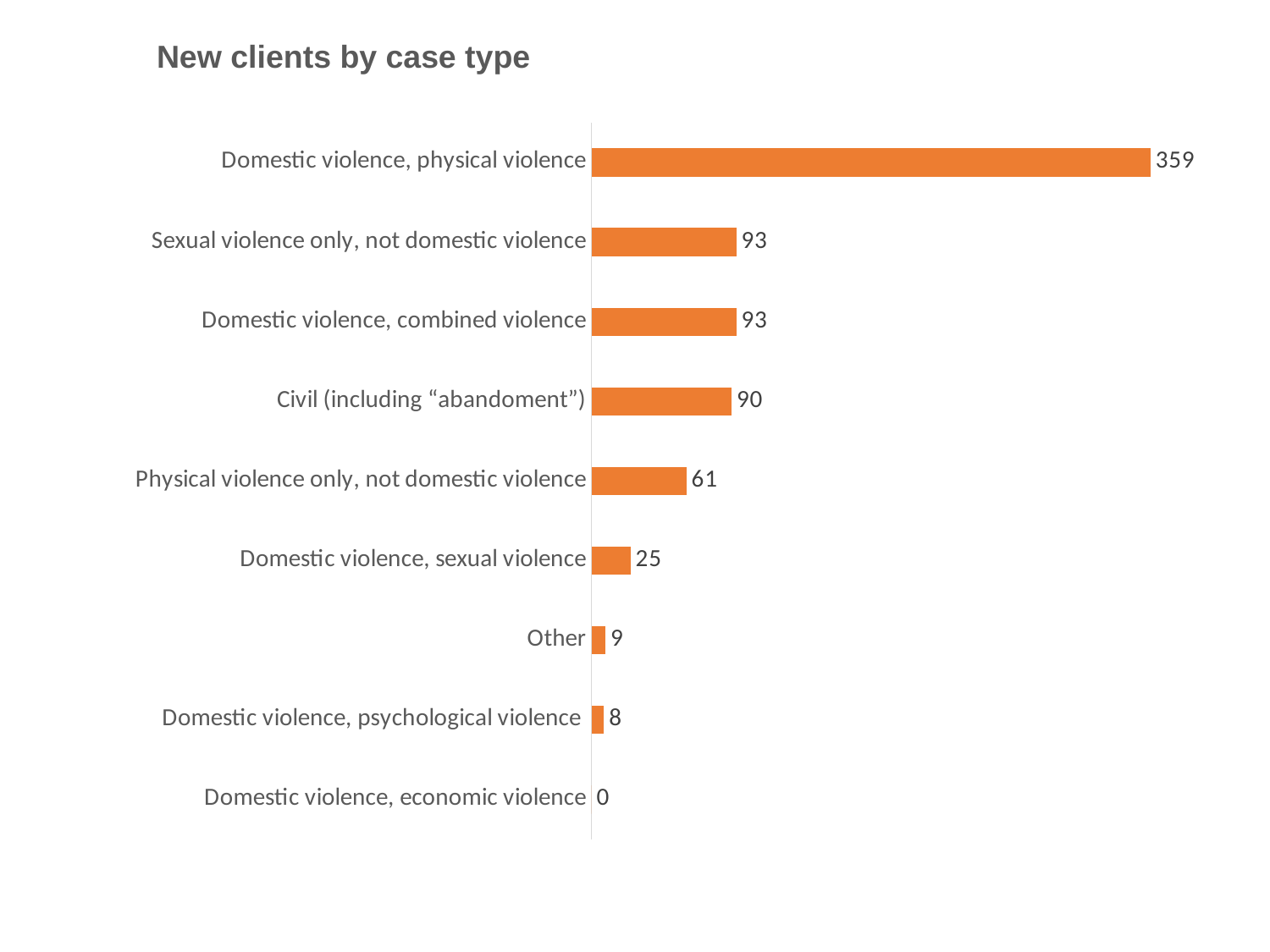
Which case type has the lowest number of new clients? Domestic violence, economic violence What kind of chart is shown on the slide? Bar chart What is the title of the chart? New clients by case type What is the difference between Domestic violence, physical violence and Sexual violence only, not domestic violence? 266 Which is larger: Other or Domestic violence, psychological violence? Other What is the value for Physical violence only, not domestic violence? 61 What is the value for Domestic violence, physical violence? 359 What is the value for Civil (including "abandoment")? 90 What is the value for Domestic violence, sexual violence? 25 How many case type categories are shown in the chart? 9 Which case type has the highest number of new clients? Domestic violence, physical violence What is the difference between Physical violence only, not domestic violence and Domestic violence, sexual violence? 36